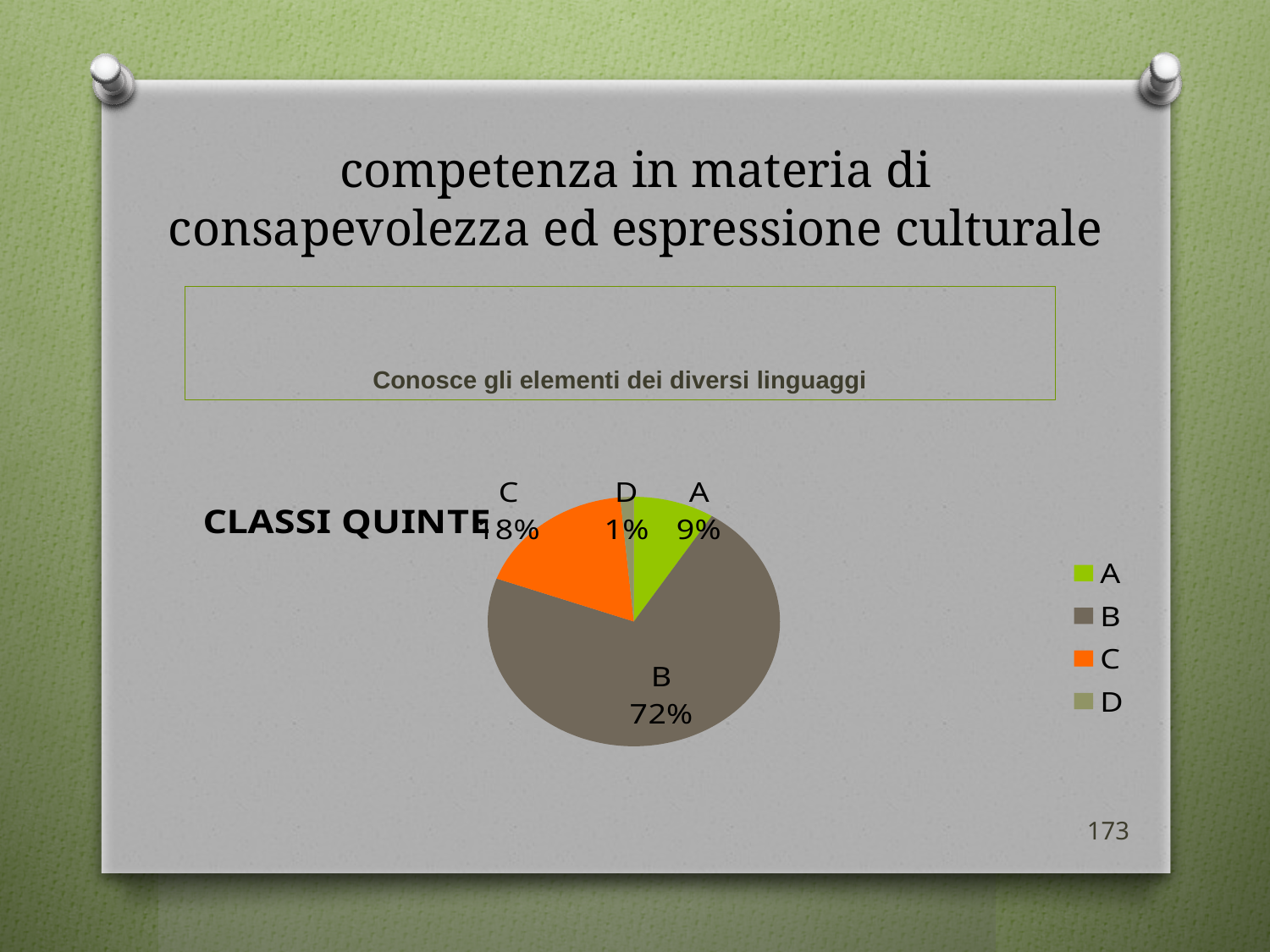
How many entries does the legend list? 4 Which category has the largest slice of the pie chart? B What percentage does slice A represent in the pie chart? 9% What colour is used for category C in the legend? orange What percentage does slice C represent in the pie chart? 18% What kind of chart is shown on the slide? pie chart How many slices does the pie chart have? 4 What percentage does slice B represent in the pie chart? 72% What is the difference in percentage points between slice B and slice A? 63% Which category has the smallest slice of the pie chart? D What percentage does slice D represent in the pie chart? 1% Which slice is larger, A or C? C